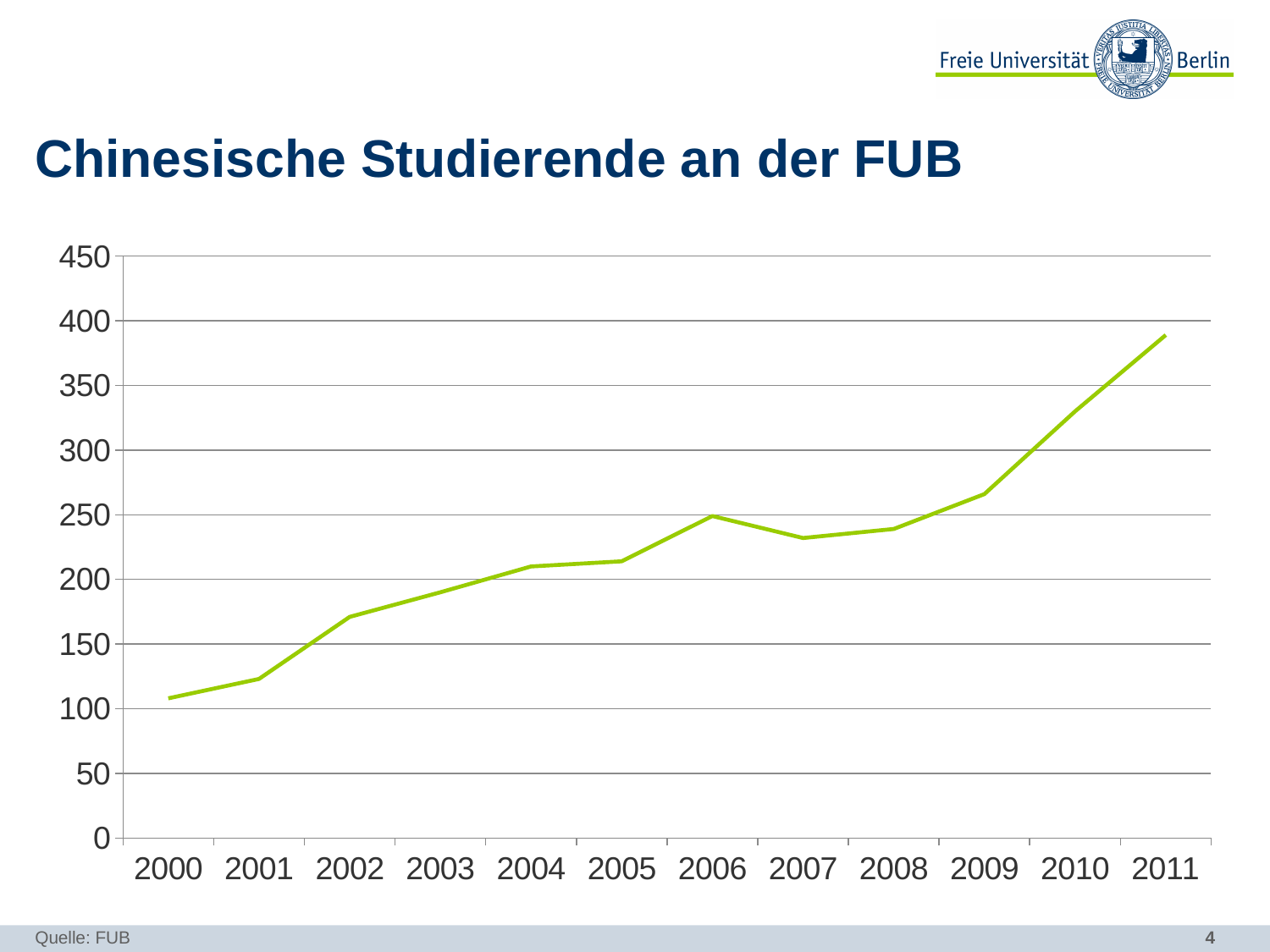
Is the value for 2002 greater or less than 150? greater Which year has the lowest value in the chart? 2000 Which year has the highest value in the chart? 2011 Is the value for 2010 greater or less than 300? greater Is the value for 2000 greater or less than 100? greater What is the title of the chart on the slide? Chinesische Studierende an der FUB How many years are plotted along the x axis of the chart? 12 Which year has the larger value, 2006 or 2007? 2006 Do the values generally rise or fall from 2000 to 2011? rise What kind of chart is shown on the slide? line chart